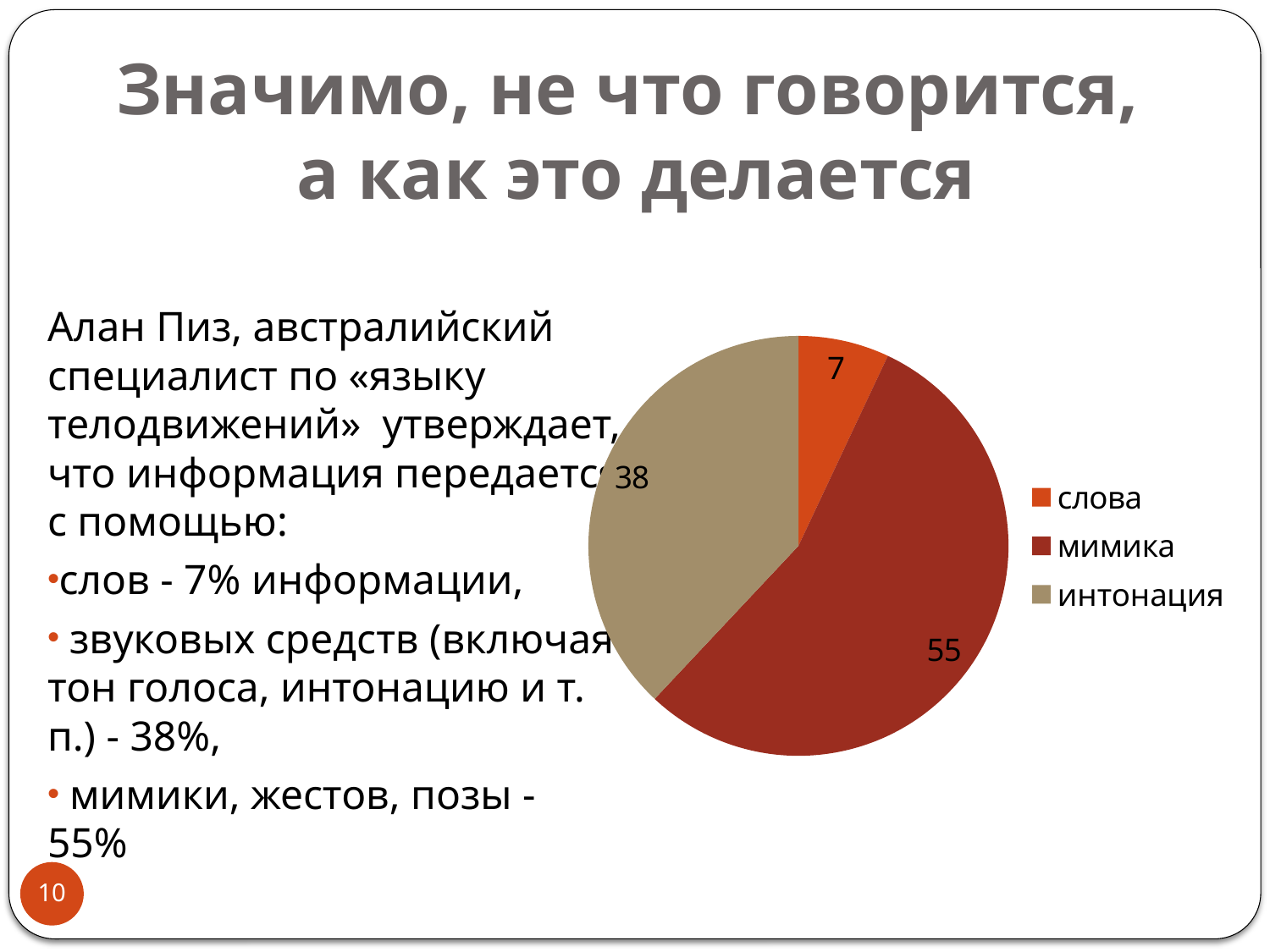
What is the difference between the values for мимика and интонация? 17 How many entries does the legend list? 3 What colour is the мимика slice in the pie chart? dark red Which category has the largest slice of the pie? мимика How many slices does the pie chart have? 3 What is the value shown for the интонация slice? 38 What is the difference between the values for интонация and слова? 31 What is the value shown for the мимика slice? 55 What kind of chart is shown on the slide? pie chart Which category has the smallest slice of the pie? слова Which is larger, the value for интонация or the value for слова? интонация What is the value shown for the слова slice? 7